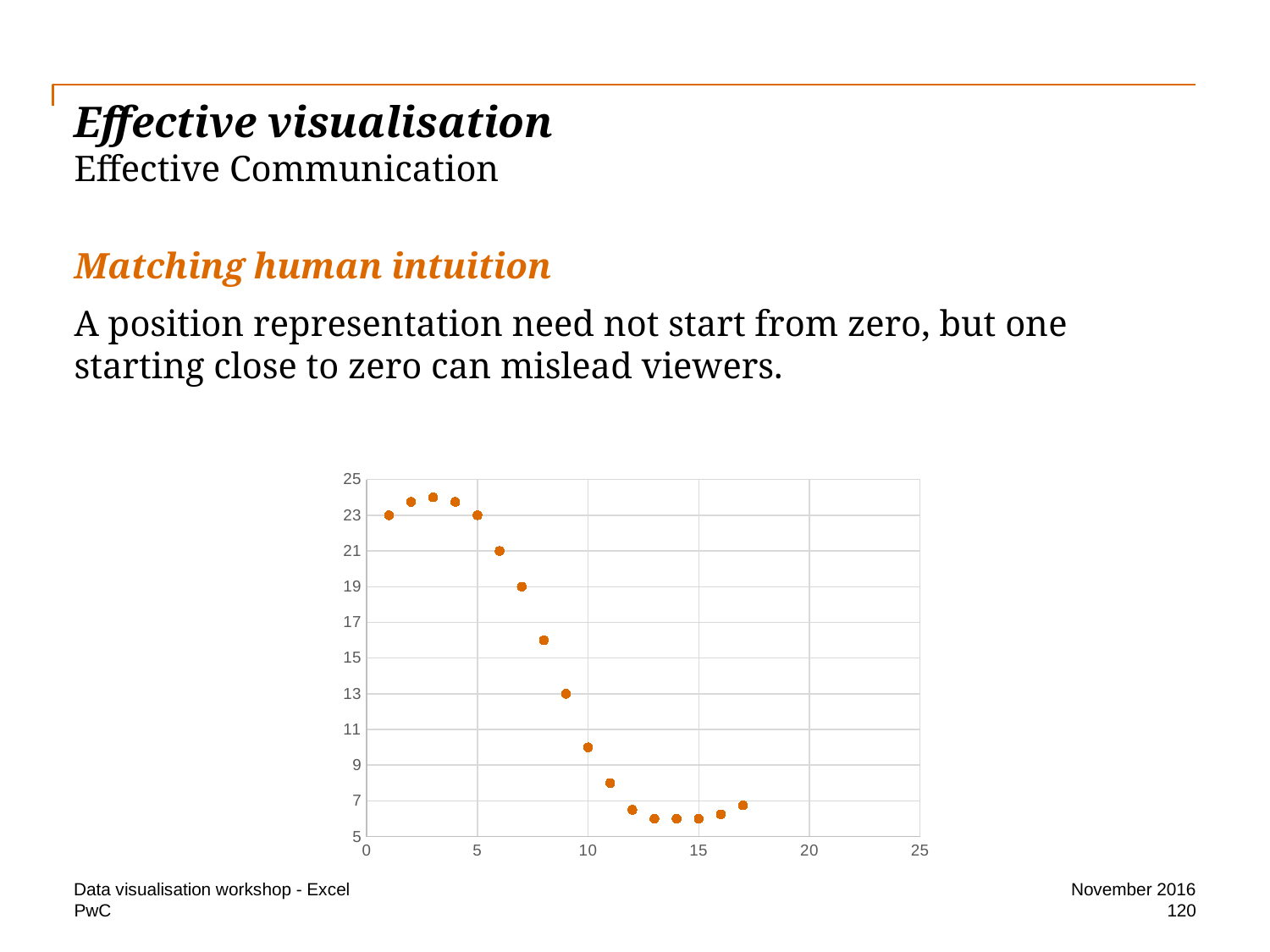
What is the highest value shown on the horizontal axis? 25 How many data points are plotted on the chart? 17 Do the plotted values generally rise or fall as x increases from 1 to 17? fall Is the value of the point at x = 1 greater or less than 21? greater Which is larger, the value at x = 5 or the value at x = 12? x = 5 At which x value does the highest point on the chart occur? 3 Is the value of the point at x = 8 greater or less than 15? greater What is the lowest value shown on the vertical axis? 5 Is the value of the point at x = 17 greater or less than 9? less What kind of chart is shown on the slide? scatter chart